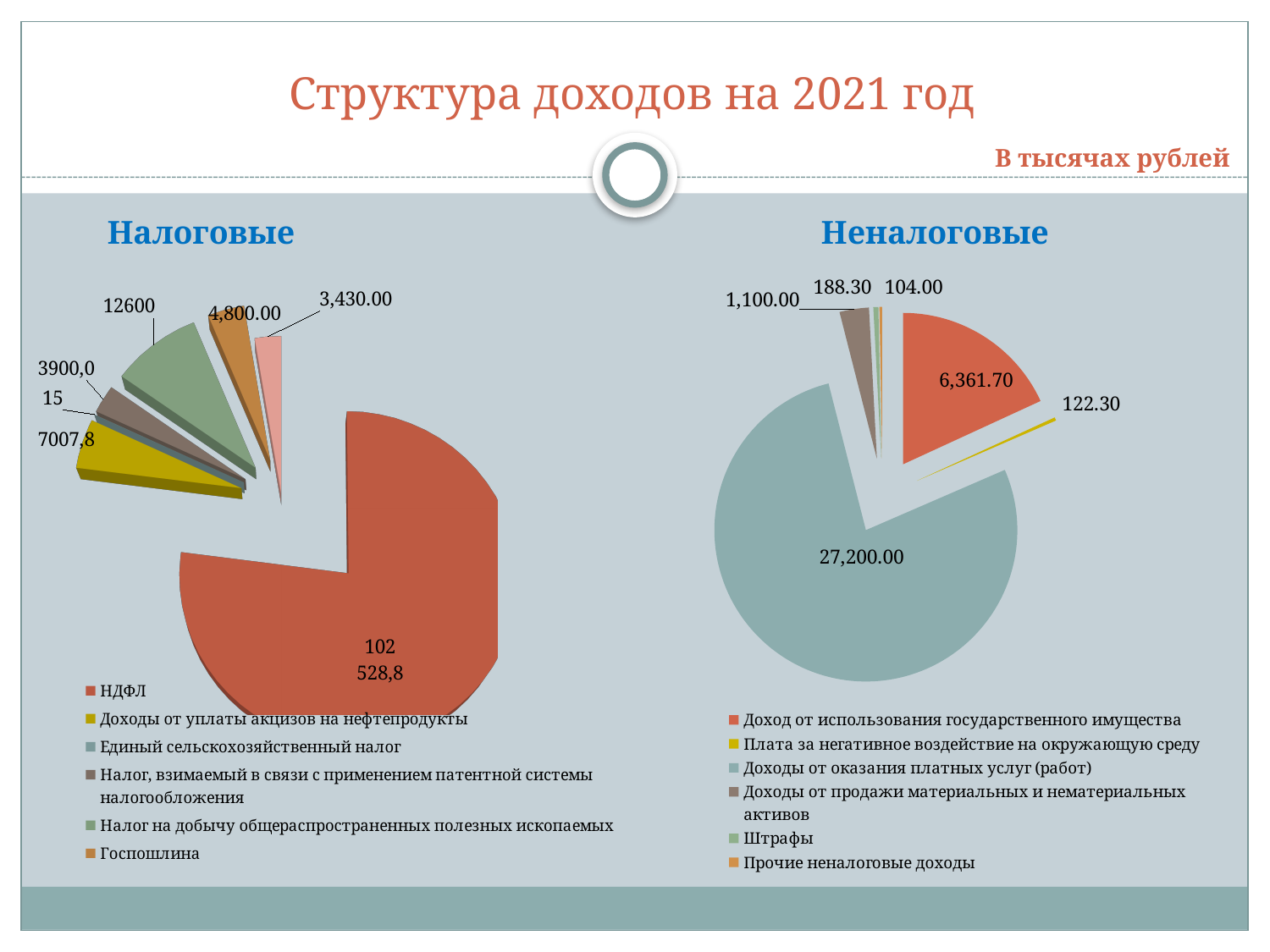
In the "Неналоговые" chart, what is the difference between Доходы от оказания платных услуг (работ) and Доход от использования государственного имущества? 20,838.30 In the "Неналоговые" chart, what is the value for Доходы от оказания платных услуг (работ)? 27,200.00 How many entries does the legend of the "Налоговые" chart list? 6 What type of chart is used for the "Налоговые" chart on the left? pie chart In the "Неналоговые" chart, what is the value for Штрафы? 188.30 In what units are the values on the slide expressed, according to the note at the top right? В тысячах рублей In the "Налоговые" chart, what is the value for Налог на добычу общераспространенных полезных ископаемых? 12600 In the "Неналоговые" chart, which category has the smallest value? Прочие неналоговые доходы In the "Налоговые" chart, which category has the largest slice? НДФЛ In the "Налоговые" chart, what is the value for НДФЛ? 102 528,8 In the "Неналоговые" chart, which is larger: Доходы от продажи материальных и нематериальных активов or Плата за негативное воздействие на окружающую среду? Доходы от продажи материальных и нематериальных активов In the "Налоговые" chart, what is the value for Госпошлина? 4,800.00